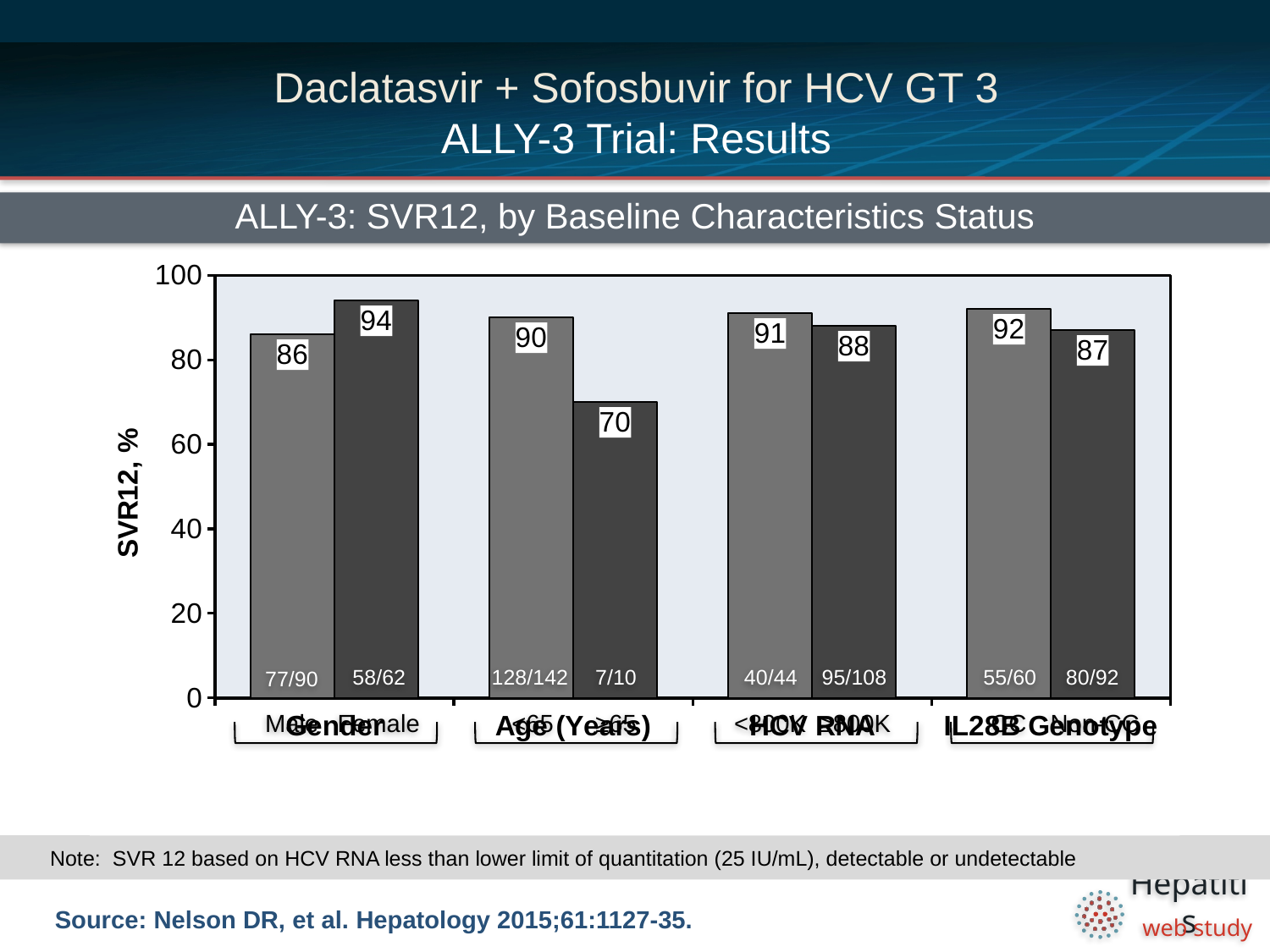
What is the label of the y-axis? SVR12, % What fraction is printed at the base of the bar with an SVR12 value of 92? 55/60 What kind of chart is shown on the slide? bar chart What is the highest SVR12 value shown in the chart? 94 What is the SVR12 value for the second bar in the IL28B Genotype group (labeled 80/92)? 87 What is the SVR12 value for the first bar in the Gender group (labeled 77/90)? 86 What is the difference between the two SVR12 values in the Age (Years) group? 20 How many bars are plotted in the chart? 8 What is the difference between the two SVR12 values in the Gender group? 8 What is the lowest SVR12 value shown in the chart? 70 In the HCV RNA group, which bar has the higher SVR12 value, the one labeled 40/44 or the one labeled 95/108? 40/44 What is the SVR12 value for the second bar in the Gender group (labeled 58/62)? 94